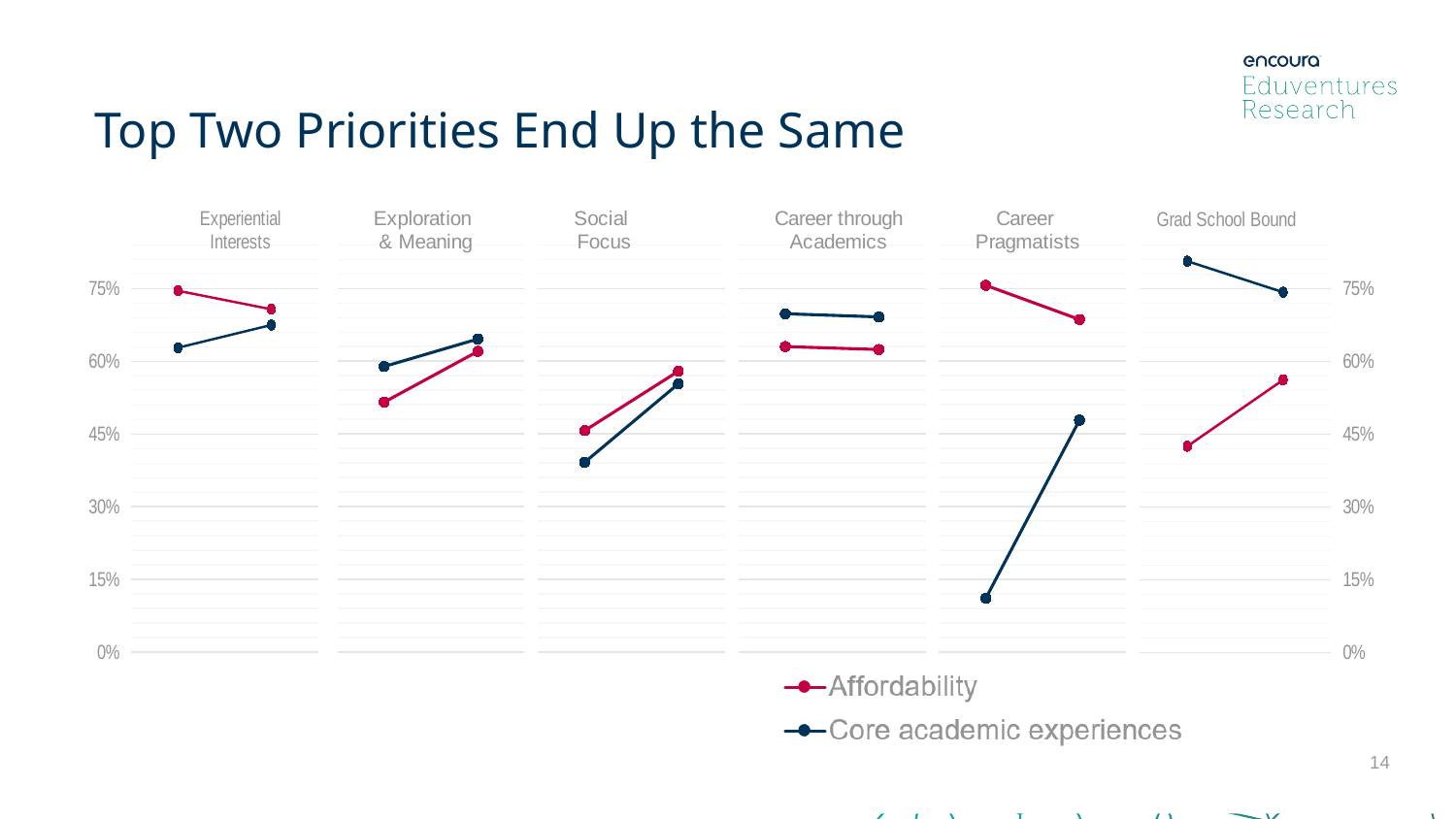
How many student segment panels are shown on the slide? 6 What colour is the Affordability line in the legend? red In the Career Pragmatists panel, is the first value for Core academic experiences greater or less than 15%? less In the Career through Academics panel, which series has the higher values, Affordability or Core academic experiences? Core academic experiences How many series does the legend list? 2 In the Social Focus panel, is the first value for Core academic experiences greater or less than 45%? less In the Grad School Bound panel, is the first value for Core academic experiences greater or less than 75%? greater What is the title of the slide's chart? Top Two Priorities End Up the Same In the Career Pragmatists panel, which series starts higher at the left point, Affordability or Core academic experiences? Affordability In the Career Pragmatists panel, does the Core academic experiences line rise or fall from left to right? rise In the Experiential Interests panel, does the Affordability line rise or fall from left to right? fall What kind of chart is used on this slide? line chart